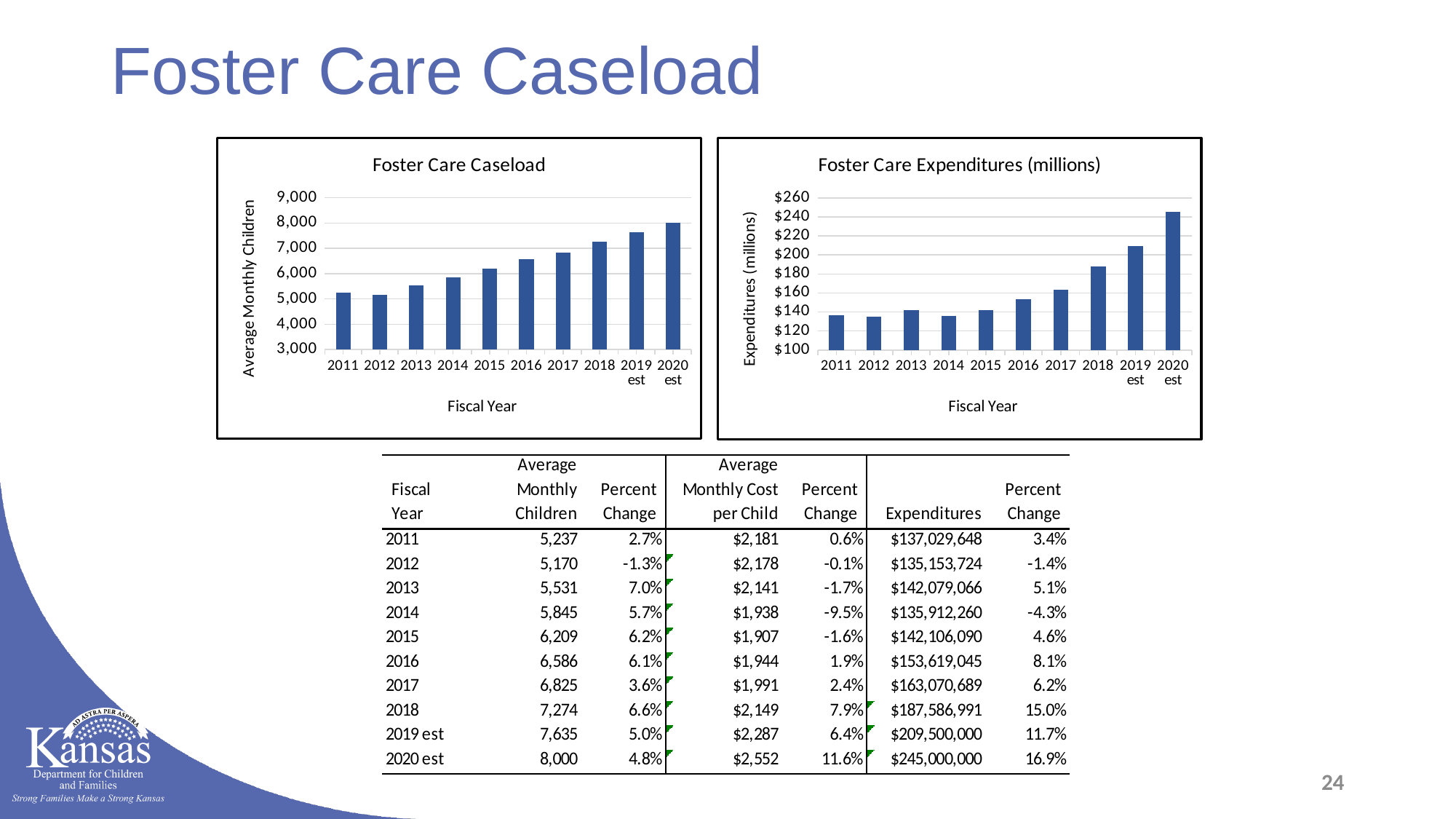
On the Foster Care Caseload chart, what is the value for 2020 est? 8,000 On the Foster Care Expenditures (millions) chart, do the values generally rise or fall from 2014 to 2020 est? rise On the Foster Care Caseload chart, is the value for 2013 greater or less than 6,000? less On the Foster Care Caseload chart, which fiscal year has the highest average monthly children? 2020 est What kind of chart is the Foster Care Caseload chart? bar chart On the Foster Care Expenditures (millions) chart, which fiscal year has the highest expenditures? 2020 est On the Foster Care Caseload chart, what is the value for 2011? 5,237 How many fiscal years are plotted on the Foster Care Caseload chart? 10 On the Foster Care Expenditures (millions) chart, is the value for 2018 greater or less than $200? less What is the y-axis title of the Foster Care Expenditures (millions) chart? Expenditures (millions) On the Foster Care Caseload chart, which is larger, the value for 2016 or the value for 2017? 2017 On the Foster Care Caseload chart, what is the difference between the values for 2020 est and 2019 est? 365